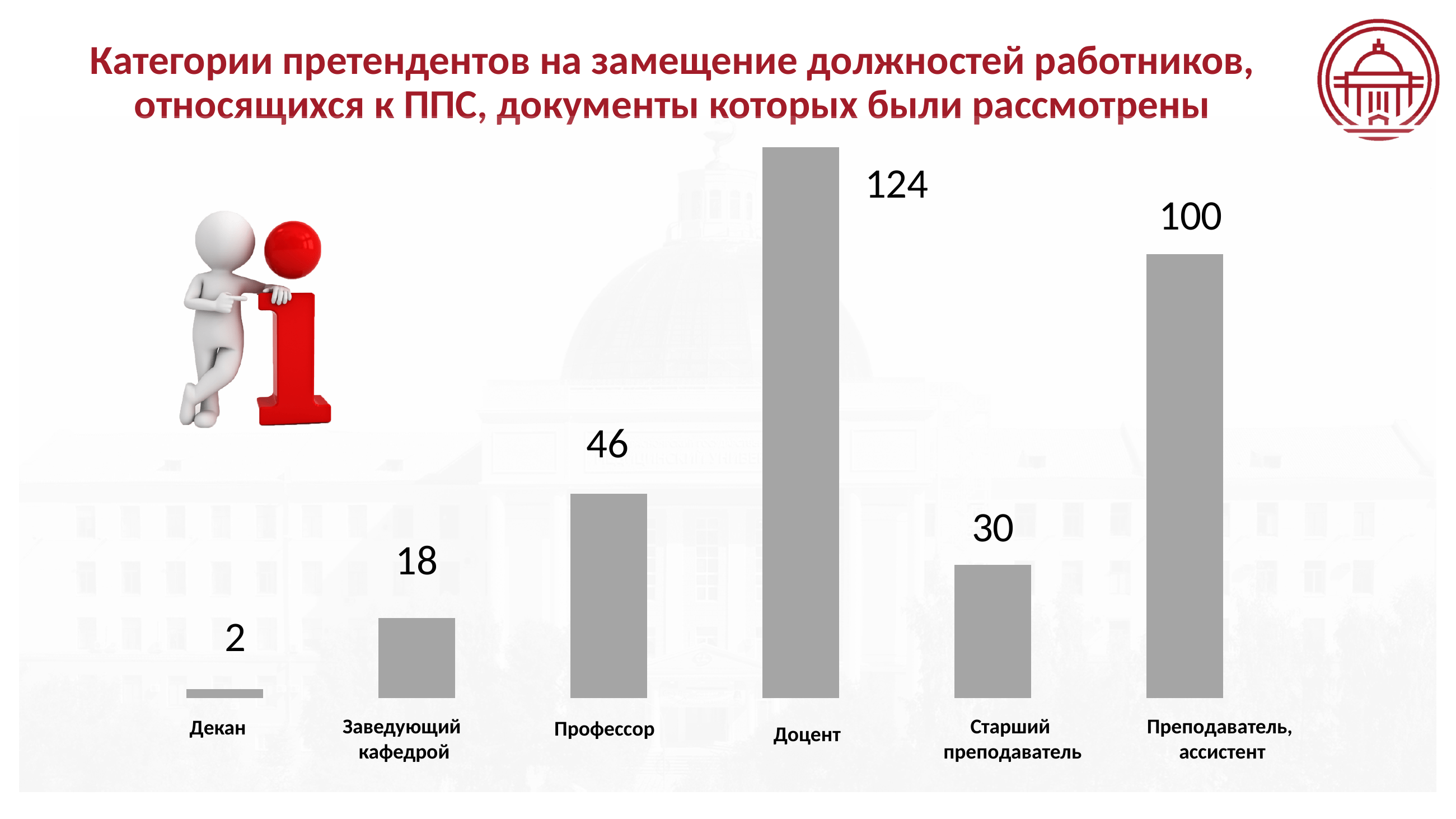
What is the value for Доцент? 124 What is the value for Декан? 2 Which is larger, the value for Профессор or the value for Старший преподаватель? Профессор What is the value for Старший преподаватель? 30 Which category has the lowest value? Декан How many categories are shown in the chart? 6 What is the value for Заведующий кафедрой? 18 What is the difference between the values for Доцент and Преподаватель, ассистент? 24 What kind of chart is shown on the slide? bar chart Which category has the highest value? Доцент What is the difference between the values for Профессор and Старший преподаватель? 16 What is the value for Преподаватель, ассистент? 100